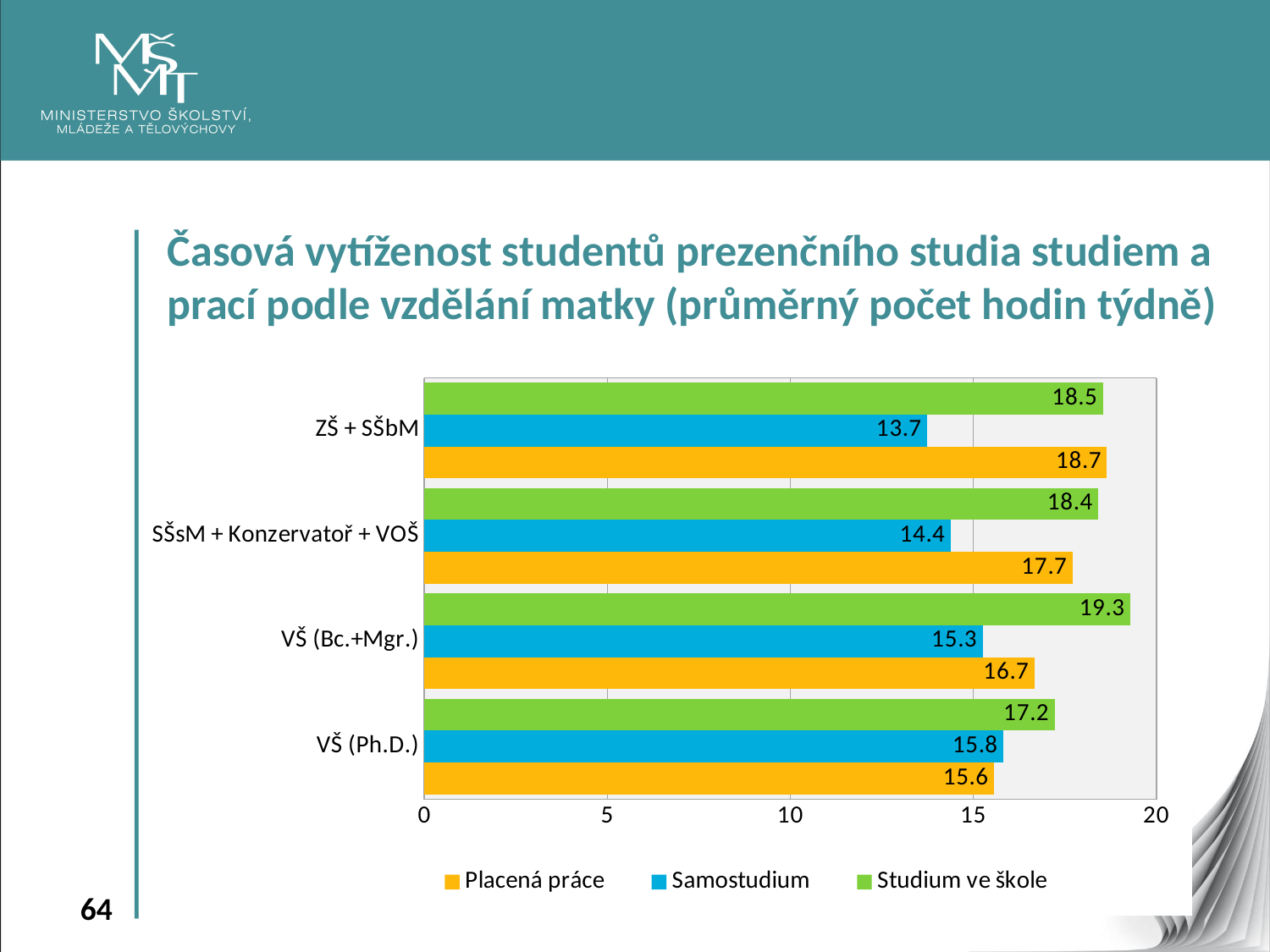
Which category has the lowest Samostudium value? ZŠ + SŠbM What is the difference between the Placená práce values for ZŠ + SŠbM and VŠ (Ph.D.)? 3.1 What is the Studium ve škole value for SŠsM + Konzervatoř + VOŠ? 18.4 How many categories are shown on the chart? 4 What kind of chart is shown on the slide? bar chart What is the Samostudium value for ZŠ + SŠbM? 13.7 Is the Samostudium value for SŠsM + Konzervatoř + VOŠ greater or less than 15? less What is the Placená práce value for VŠ (Bc.+Mgr.)? 16.7 Which is larger for VŠ (Ph.D.): Samostudium or Placená práce? Samostudium Which colour represents Placená práce in the chart? orange Which category has the highest Studium ve škole value? VŠ (Bc.+Mgr.) How many series does the legend list? 3